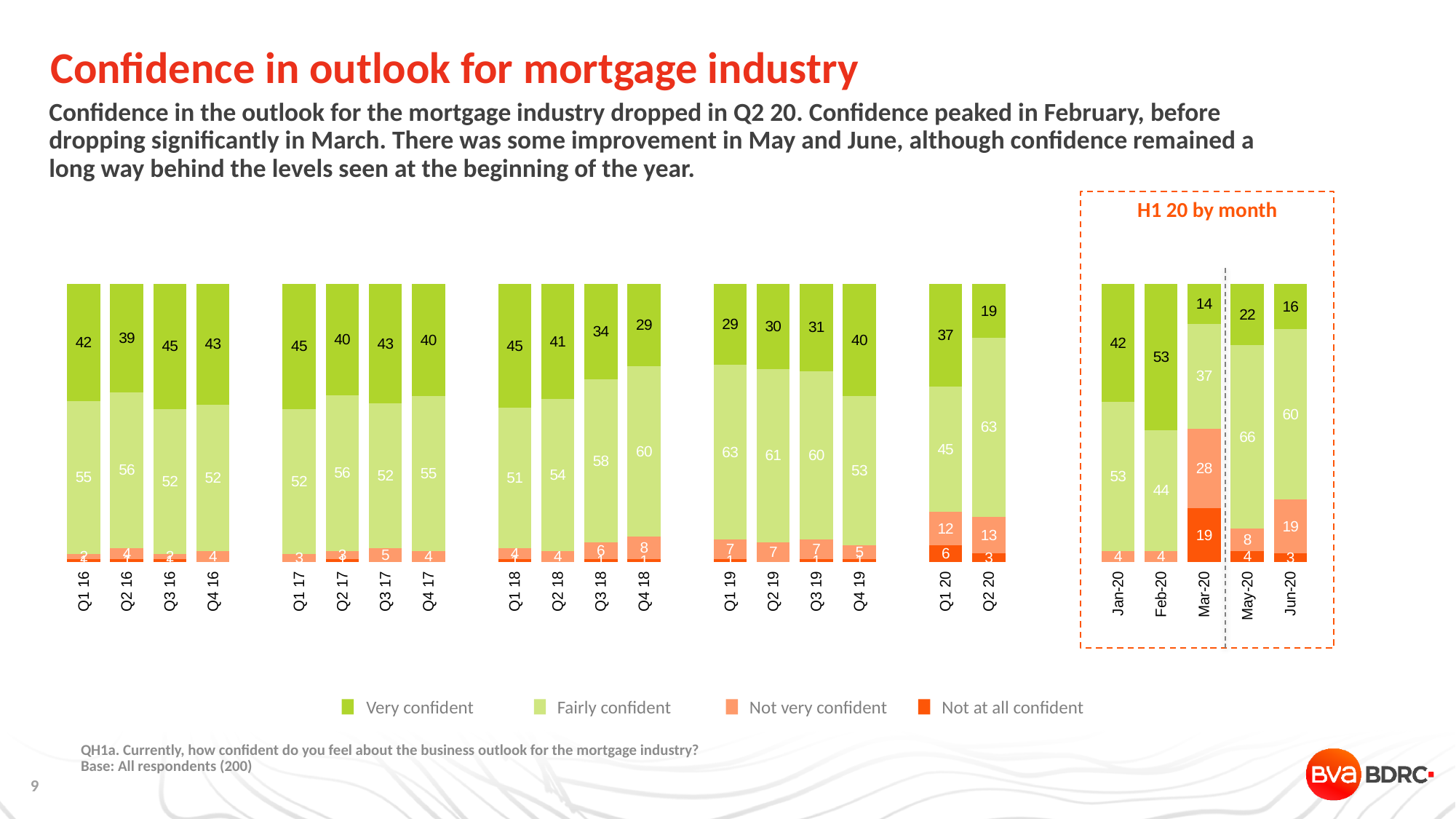
How many series does the legend list? 4 What is the difference between the 'Very confident' values for Feb-20 and Mar-20? 39 What is the 'Very confident' value for Feb-20? 53 What is the 'Not very confident' value for Mar-20? 28 Which is larger, the 'Very confident' value for Q1 20 or for Q2 20? Q1 20 How many monthly bars are shown inside the 'H1 20 by month' box? 5 Among the monthly bars in the 'H1 20 by month' box, which month has the lowest 'Very confident' value? Mar-20 Does the 'Very confident' value rise or fall from Q1 19 to Q4 19? Rise What is the 'Fairly confident' value for Q2 20? 63 What kind of chart is shown on the slide? Stacked bar chart Among the monthly bars in the 'H1 20 by month' box, which month has the highest 'Very confident' value? Feb-20 What is the 'Not at all confident' value for Q1 20? 6